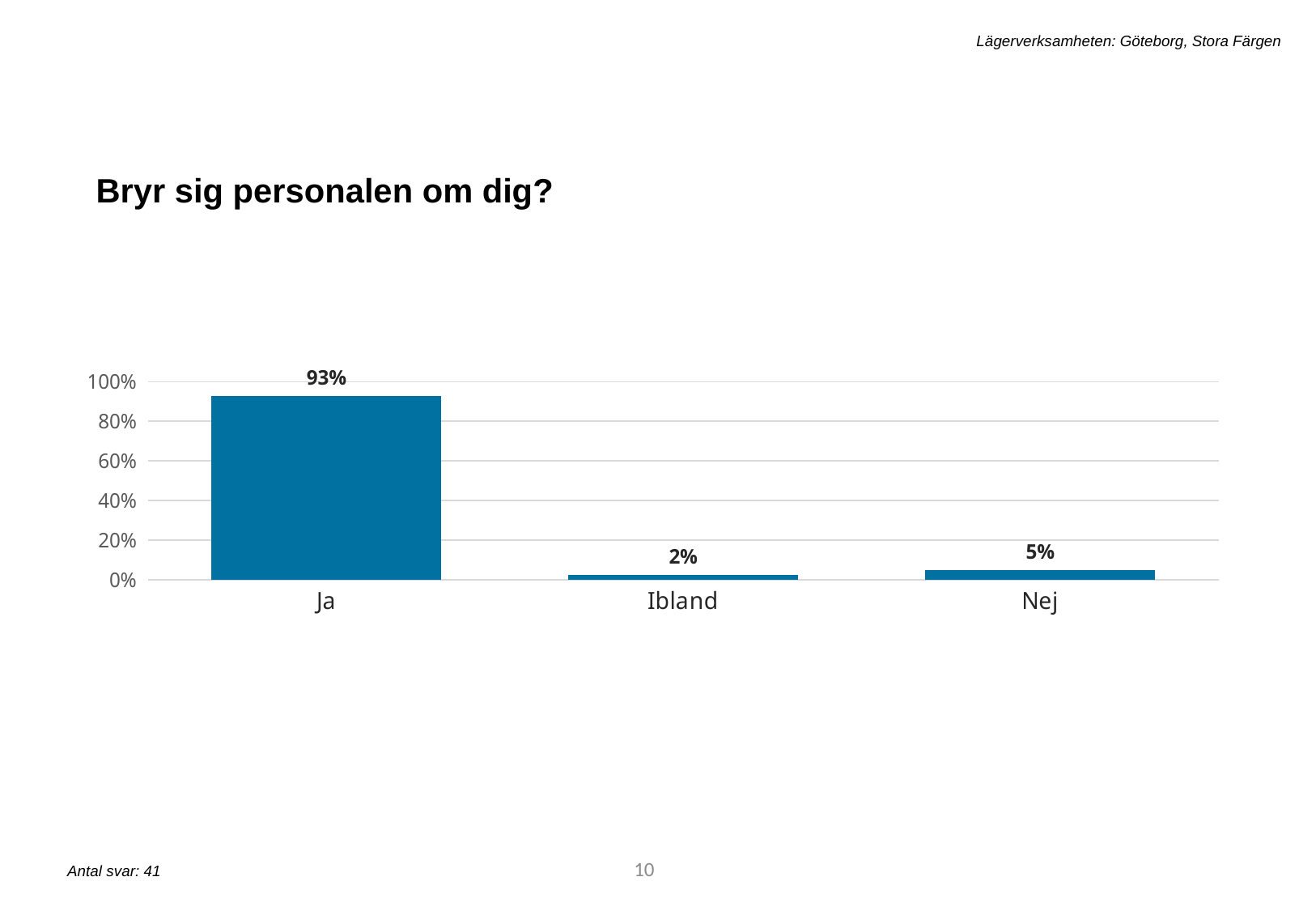
Is the value for Ja greater or less than 80%? greater What is the difference between the values for Nej and Ibland? 3% How many categories are shown on the x axis? 3 Which category has the highest value? Ja What kind of chart is shown on the slide? bar chart What is the difference between the values for Ja and Nej? 88% What is the value for Nej? 5% Which is larger, the value for Nej or the value for Ibland? Nej What is the value for Ibland? 2% What is the title of the chart? Bryr sig personalen om dig? Which category has the lowest value? Ibland What is the value for Ja? 93%